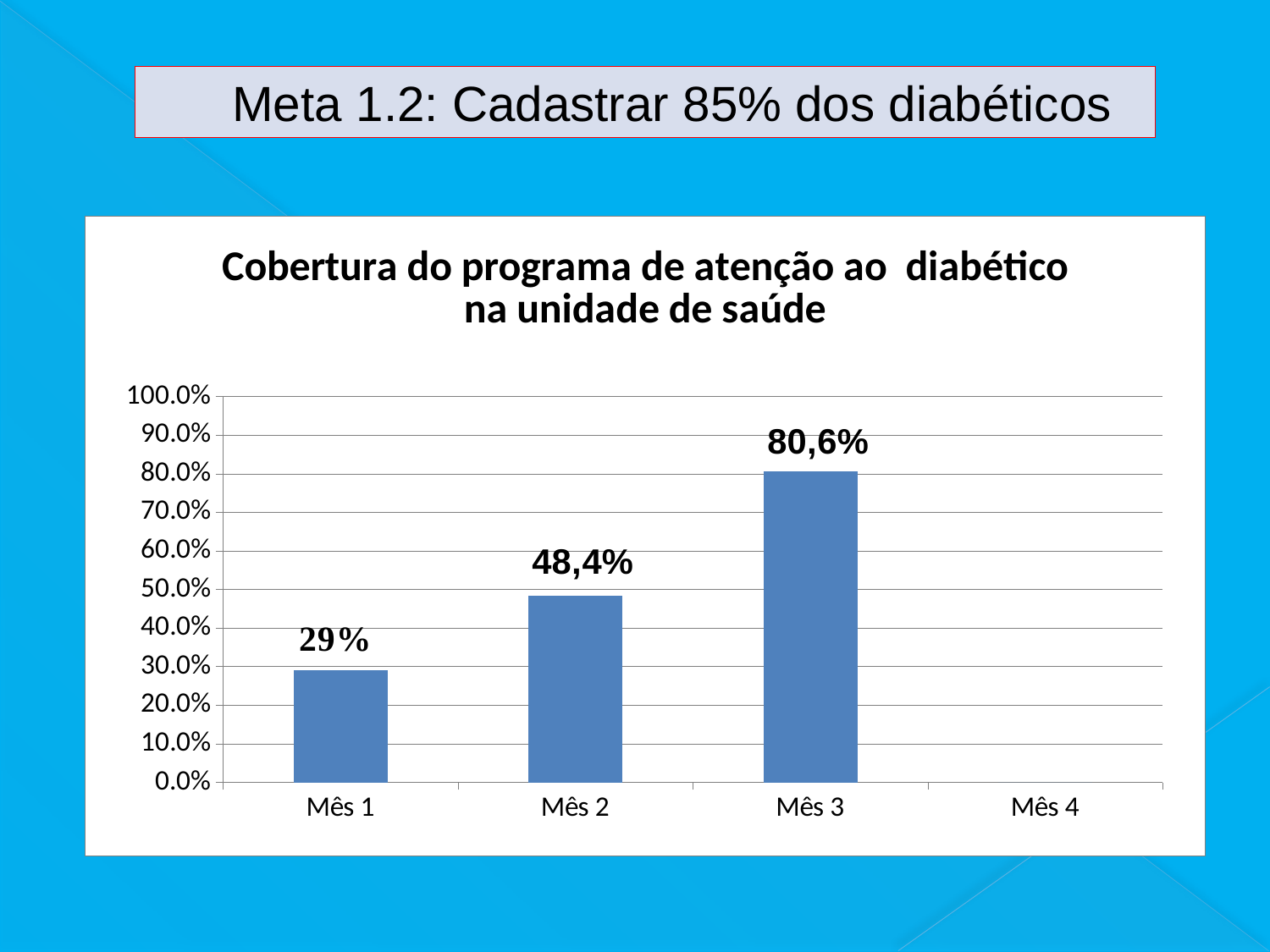
What is the value shown for Mês 1? 29% How many categories are labelled on the x axis? 4 Which is larger, the value for Mês 2 or the value for Mês 1? Mês 2 Is the value for Mês 3 greater or less than 70%? greater What is the difference between the values for Mês 3 and Mês 2? 32,2% What is the value shown for Mês 3? 80,6% Which month has the highest coverage value? Mês 3 What kind of chart is shown on the slide? bar chart What is the value shown for Mês 2? 48,4% Which month with a plotted bar has the lowest coverage value? Mês 1 What is the difference between the values for Mês 2 and Mês 1? 19,4% Do the values rise or fall from Mês 1 to Mês 3? rise